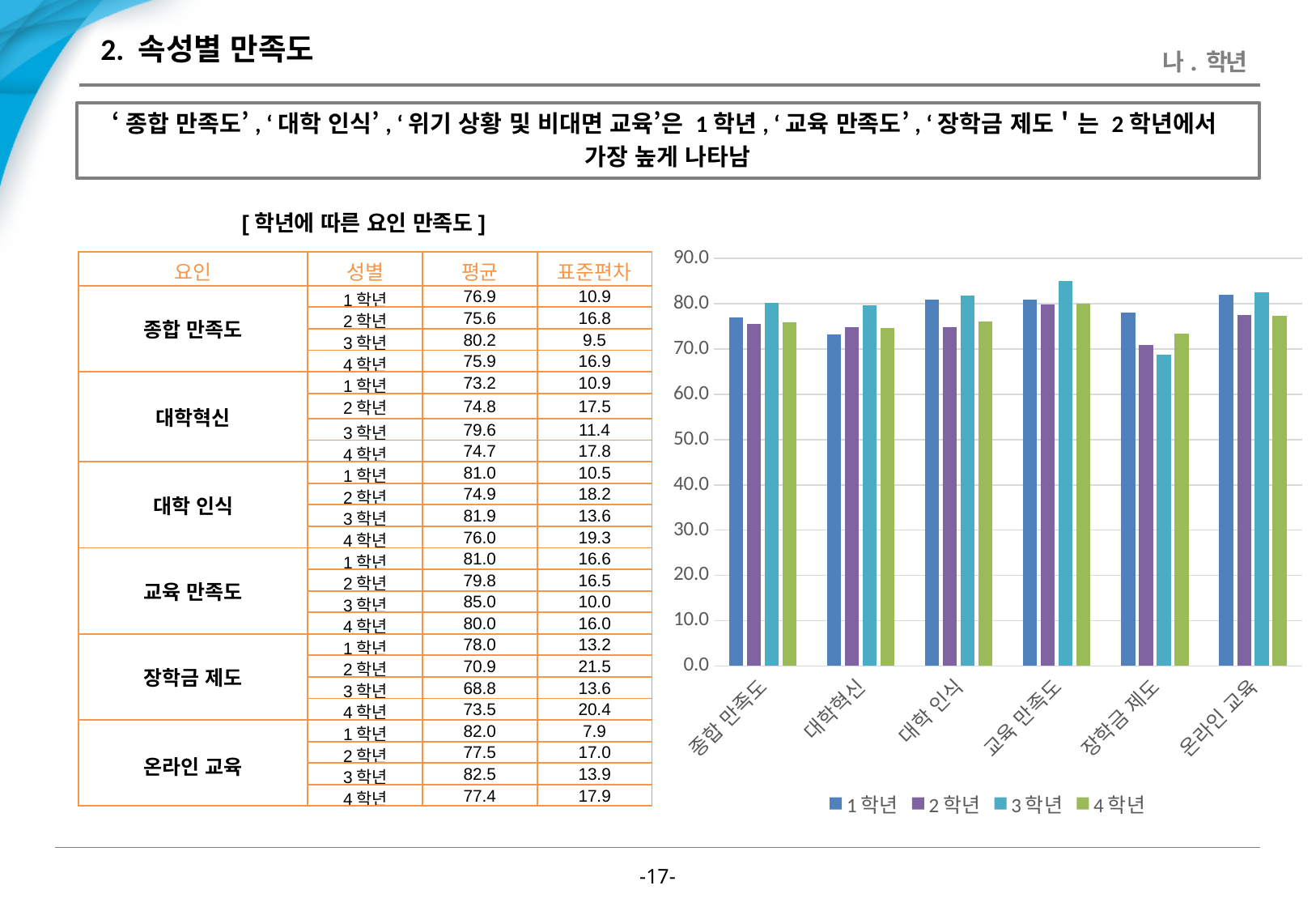
Is the 1 학년 value for 대학혁신 greater or less than 80? less How many categories are shown along the x axis of the chart? 6 What are the entries listed in the chart legend? 1 학년, 2 학년, 3 학년, 4 학년 What kind of chart is shown on the slide? bar chart Is the 3 학년 value for 교육 만족도 greater or less than 80? greater Which category has the highest 3 학년 bar? 교육 만족도 What is the difference between the 3 학년 and 2 학년 values for 온라인 교육? 5.0 Which category has the lowest 3 학년 bar? 장학금 제도 What is the 3 학년 value for 교육 만족도? 85.0 How many series does the chart legend list? 4 For 장학금 제도, which is larger: the 1 학년 value or the 2 학년 value? 1 학년 What is the 1 학년 value for 온라인 교육? 82.0